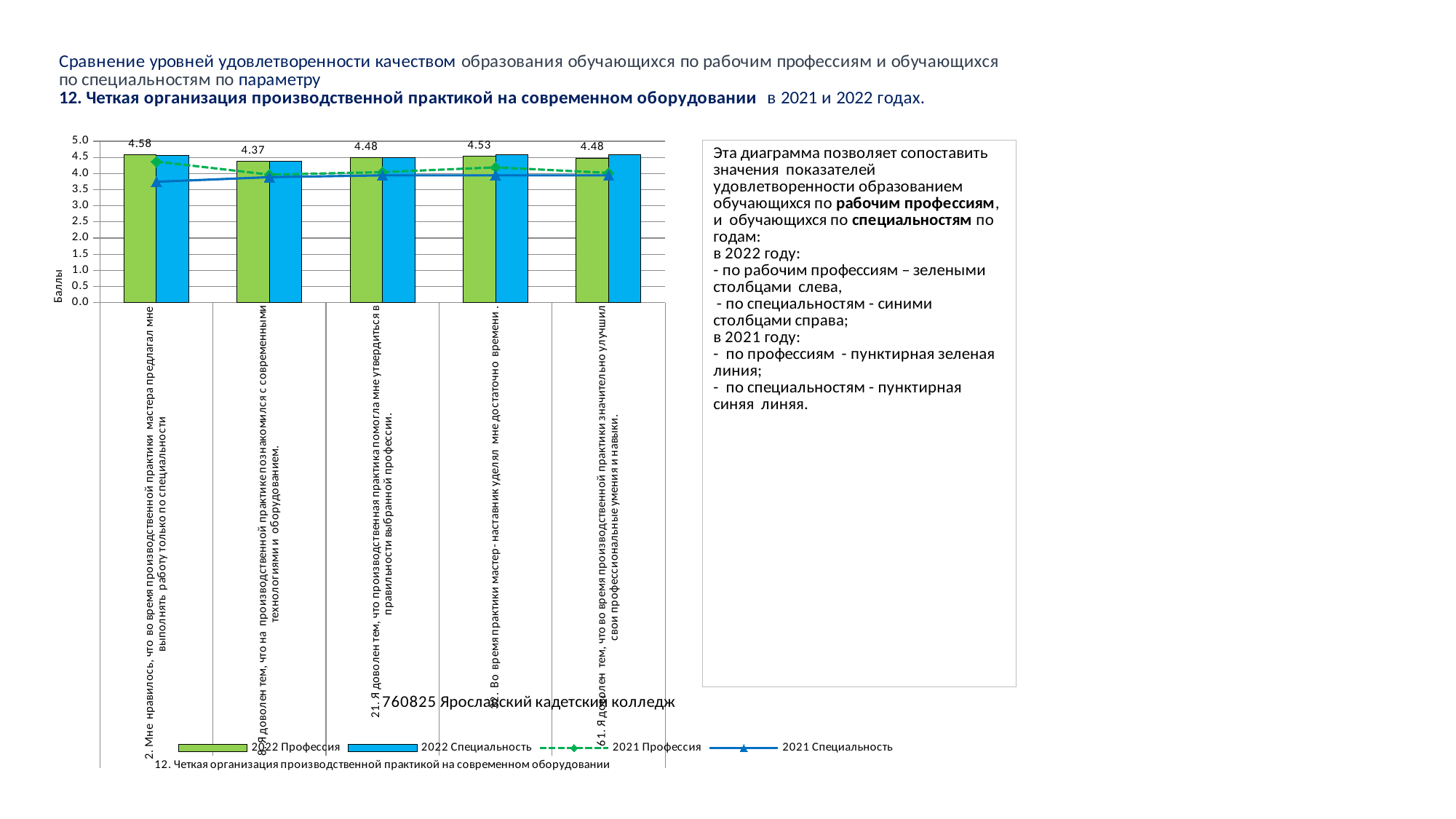
For the 2022 Профессия series, which is larger: the value for category 2 or the value for category 32? Category 2 (4.58) What is the value of the 2022 Профессия bar for category "2. Мне нравилось, что во время производственной практики мастера предлагал мне выполнять работу только по специальности"? 4.58 Which category has the highest labelled 2022 Профессия value? 2. Мне нравилось, что во время производственной практики мастера предлагал мне выполнять работу только по специальности Is the 2021 Специальность value for category 2 greater or less than 4.0? less How many categories (survey statements) are shown on the x axis? 5 Which category has the lowest labelled 2022 Профессия value? 8. Я доволен тем, что на производственной практике познакомился с современными технологиями и оборудованием What kind of chart is shown on the slide? bar chart (with line series) What is the value of the 2022 Профессия bar for category "32. Во время практики мастер-наставник уделял мне достаточно времени"? 4.53 How many series does the legend list? 4 What is the difference between the highest and lowest labelled 2022 Профессия values (4.58 and 4.37)? 0.21 What is the value of the 2022 Профессия bar for category "8. Я доволен тем, что на производственной практике познакомился с современными технологиями и оборудованием"? 4.37 What is the label of the vertical axis? Баллы